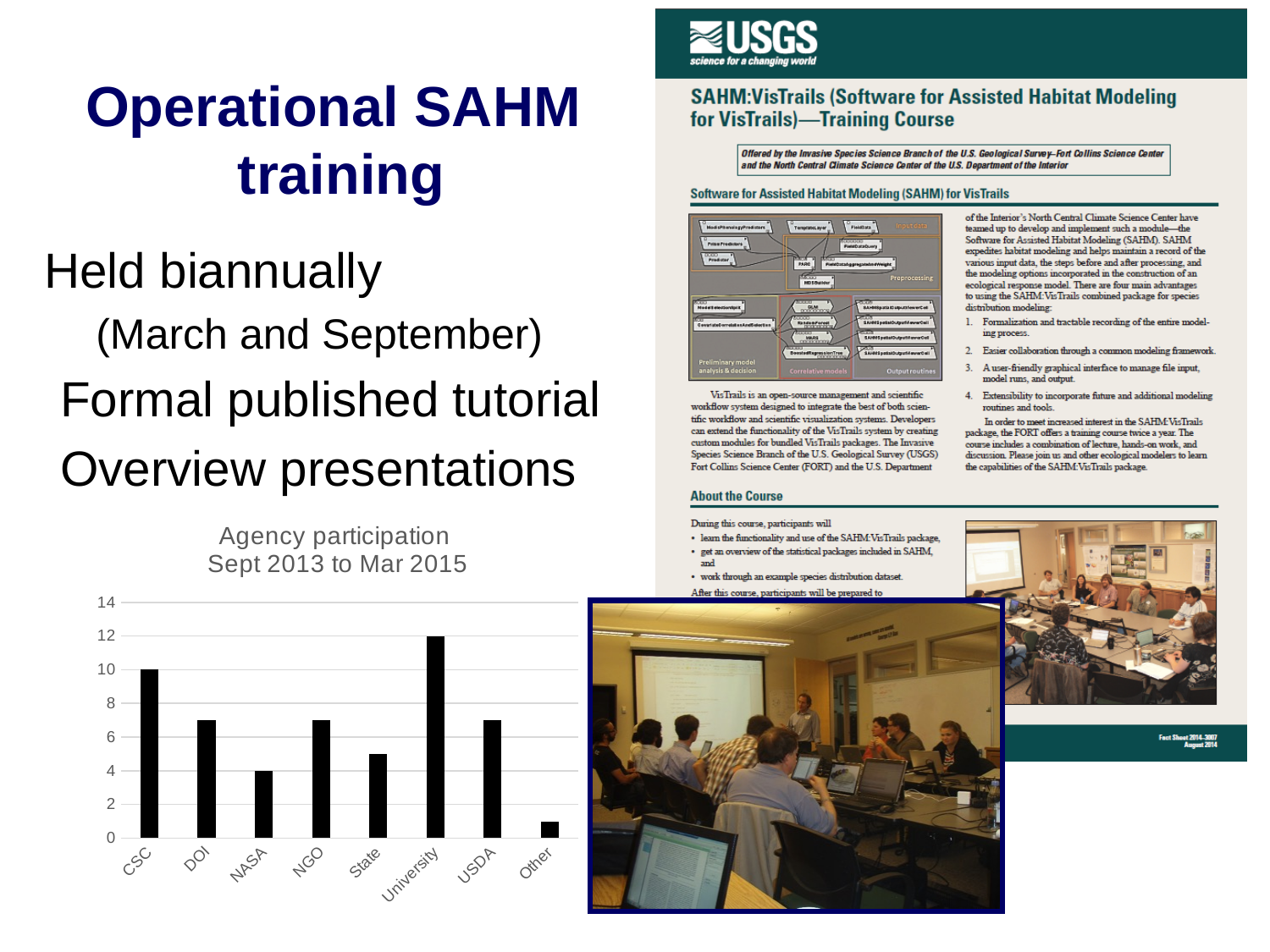
What is the title of the chart on the slide? Agency participation Sept 2013 to Mar 2015 Is the value for Other greater or less than 2? less What is the value for CSC in the chart? 10 Which is larger, the value for CSC or the value for DOI? CSC What is the value for NASA in the chart? 4 What type of chart is shown on the slide? bar chart Which category has the highest value in the chart? University Which category has the lowest value in the chart? Other What is the value for University in the chart? 12 Is the value for DOI greater or less than 6? greater What is the difference between the values for University and CSC? 2 How many categories are shown on the x axis of the chart? 8